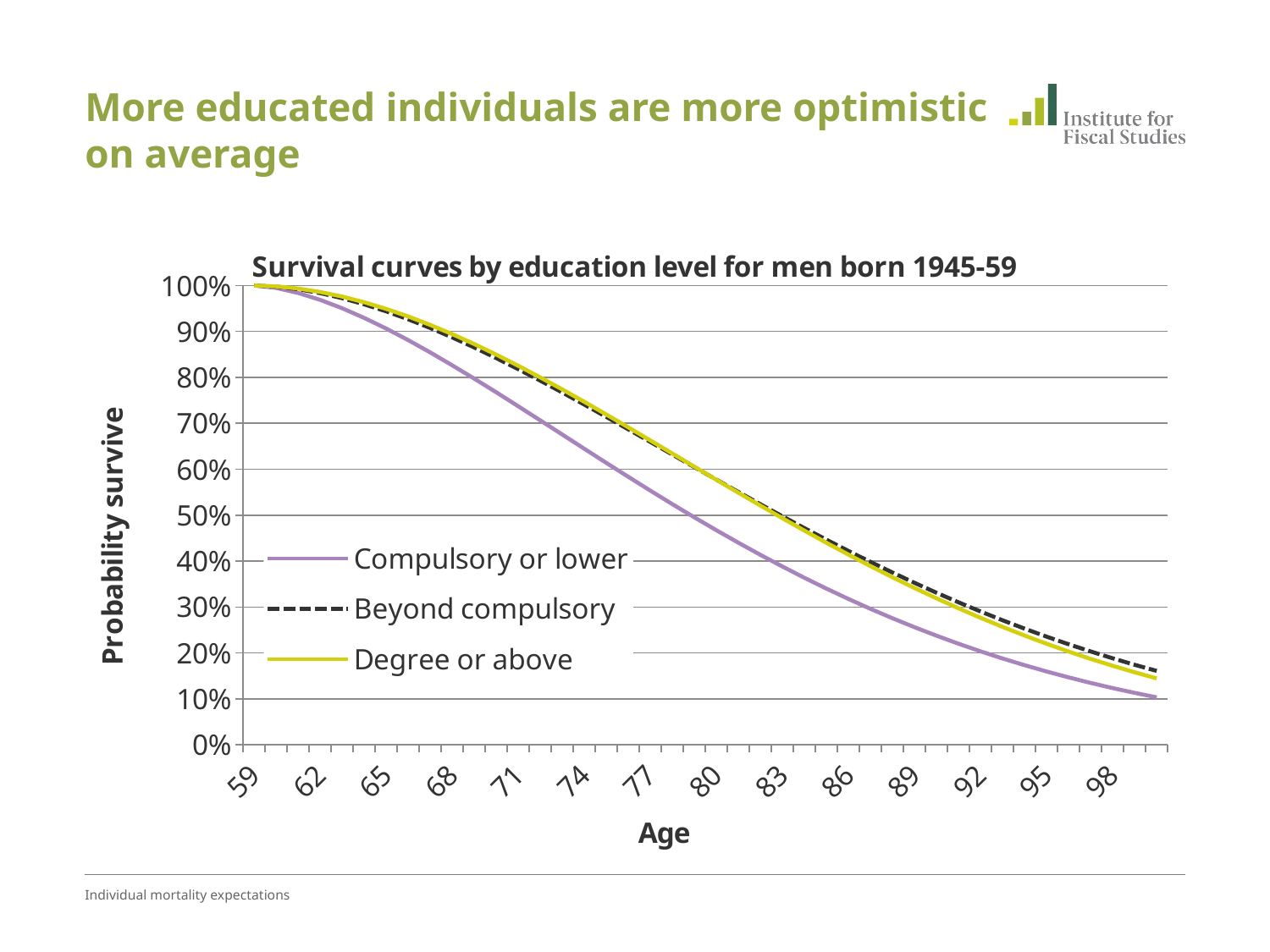
How many series does the legend list? 3 Is the value for Compulsory or lower at age 89 greater or less than 30%? less Is the value for Beyond compulsory at age 65 greater or less than 90%? greater Is the value for Compulsory or lower at age 98 greater or less than 20%? less What kind of chart is shown on the slide? line chart What is the probability survive for Compulsory or lower at age 59? 100% At age 89, which is larger: Degree or above or Compulsory or lower? Degree or above What is the title of the chart? Survival curves by education level for men born 1945-59 Do the survival probabilities rise or fall as age increases? fall Which series has the lowest probability survive at age 80? Compulsory or lower What is the label of the vertical axis? Probability survive